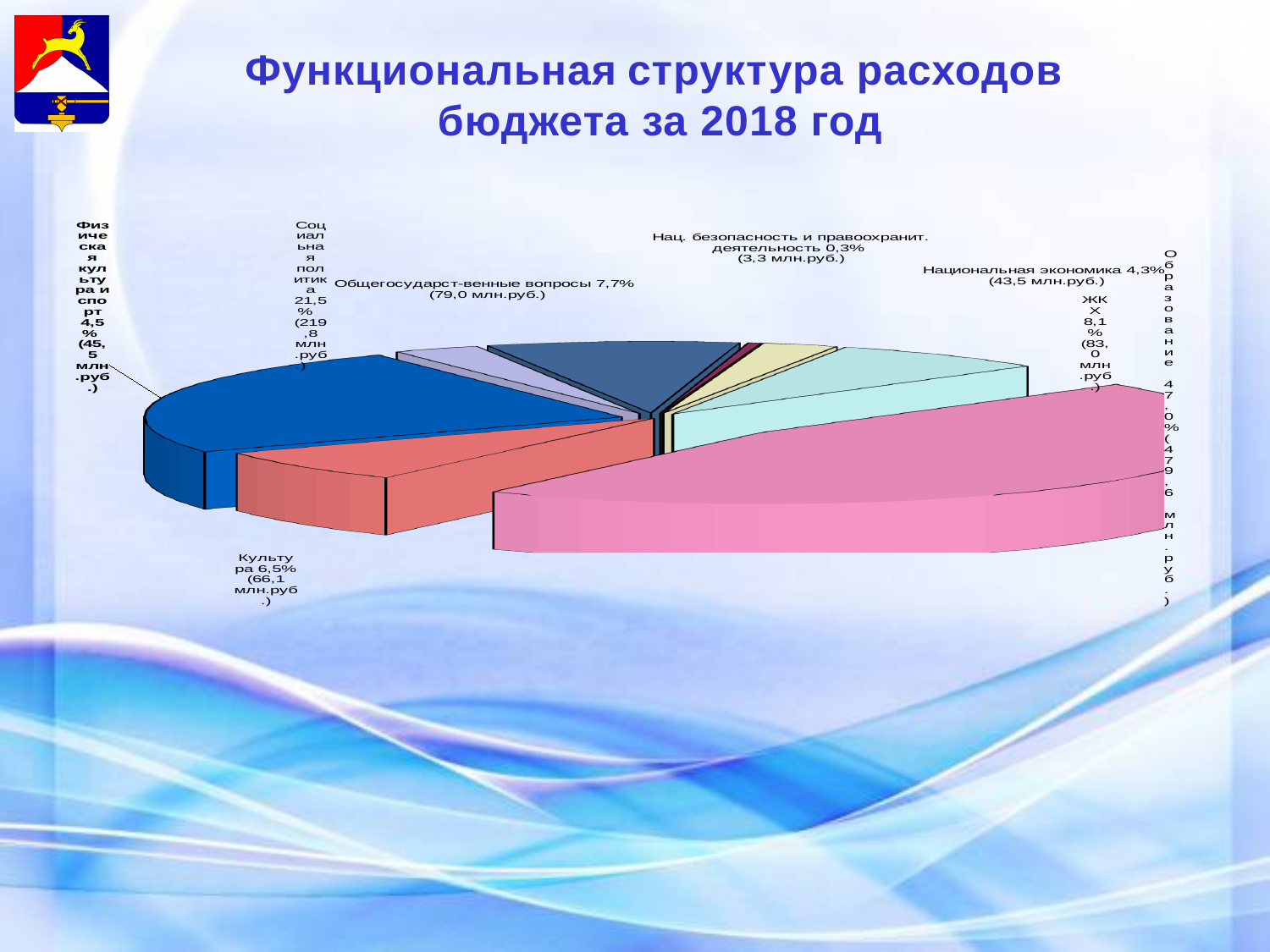
What is the amount in млн.руб. for Социальная политика? 219,8 млн.руб. What type of chart is shown on the slide? Pie chart What is the difference in percentage points between Социальная политика and Физическая культура и спорт? 17,0 How many categories (slices) does the pie chart show? 8 Which category has the smallest share of expenditure? Нац. безопасность и правоохранит. деятельность What percentage share is shown for ЖКХ? 8,1% What is the amount shown for Нац. безопасность и правоохранит. деятельность? 3,3 млн.руб. Which is larger: the share for Культура or the share for Общегосударственные вопросы? Общегосударственные вопросы Which category has the largest share of expenditure? Образование What share of budget expenditure goes to Образование? 47,0% What is the amount in млн.руб. for Национальная экономика? 43,5 млн.руб. What is the title of the chart on the slide? Функциональная структура расходов бюджета за 2018 год